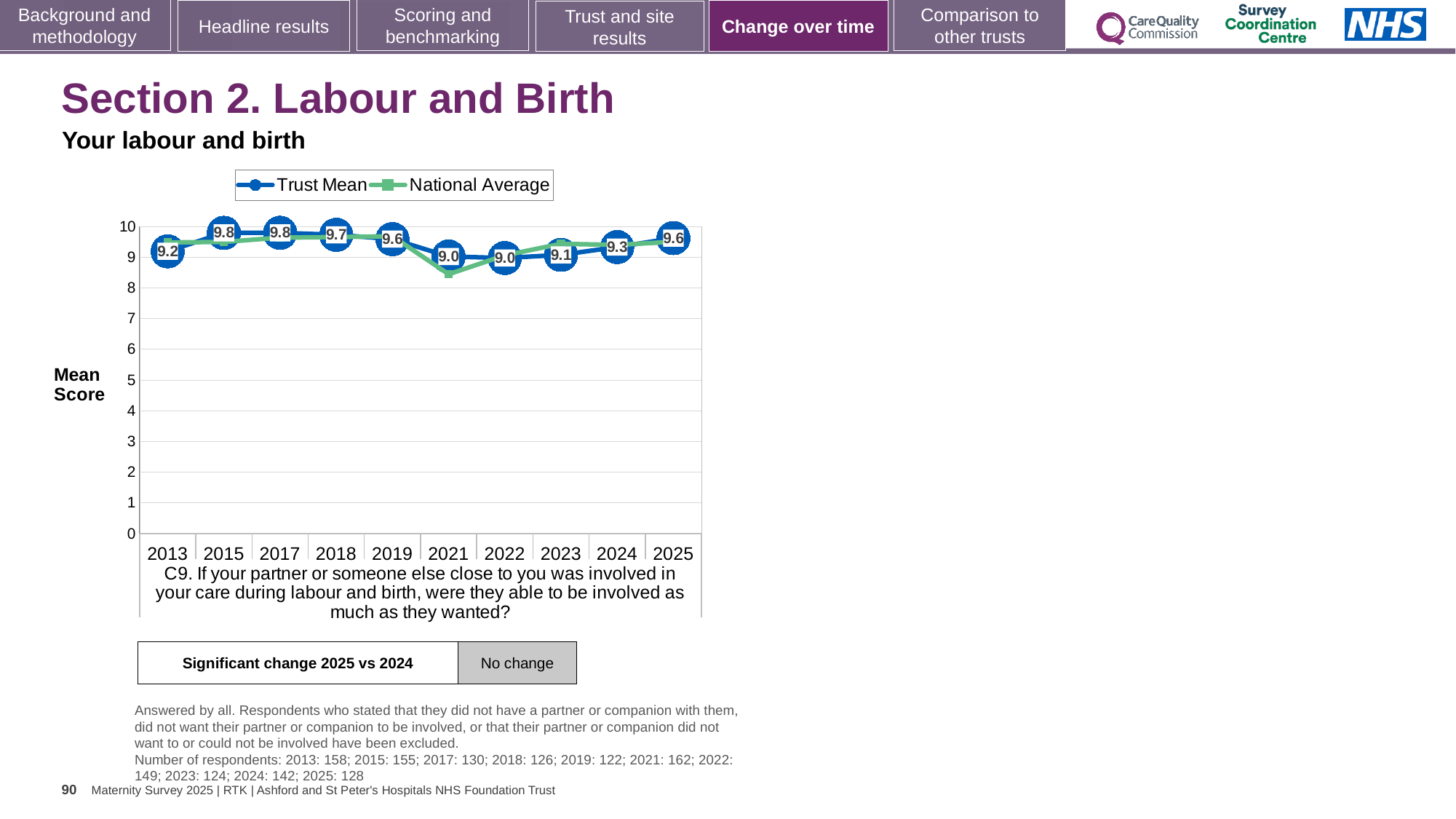
What is the Trust Mean value for 2013? 9.2 How many series does the legend list? 2 Is the National Average value for 2021 greater or less than 9? less What kind of chart is shown on the slide? line chart What is the Trust Mean value for 2018? 9.7 What is the difference between the Trust Mean values for 2025 and 2024? 0.3 What are the two series named in the legend? Trust Mean and National Average Which year has the larger Trust Mean value, 2015 or 2021? 2015 How many years are plotted on the x axis? 10 Does the Trust Mean rise or fall from 2021 to 2025? rise What is the Trust Mean value for 2025? 9.6 What is the Trust Mean value for 2021? 9.0